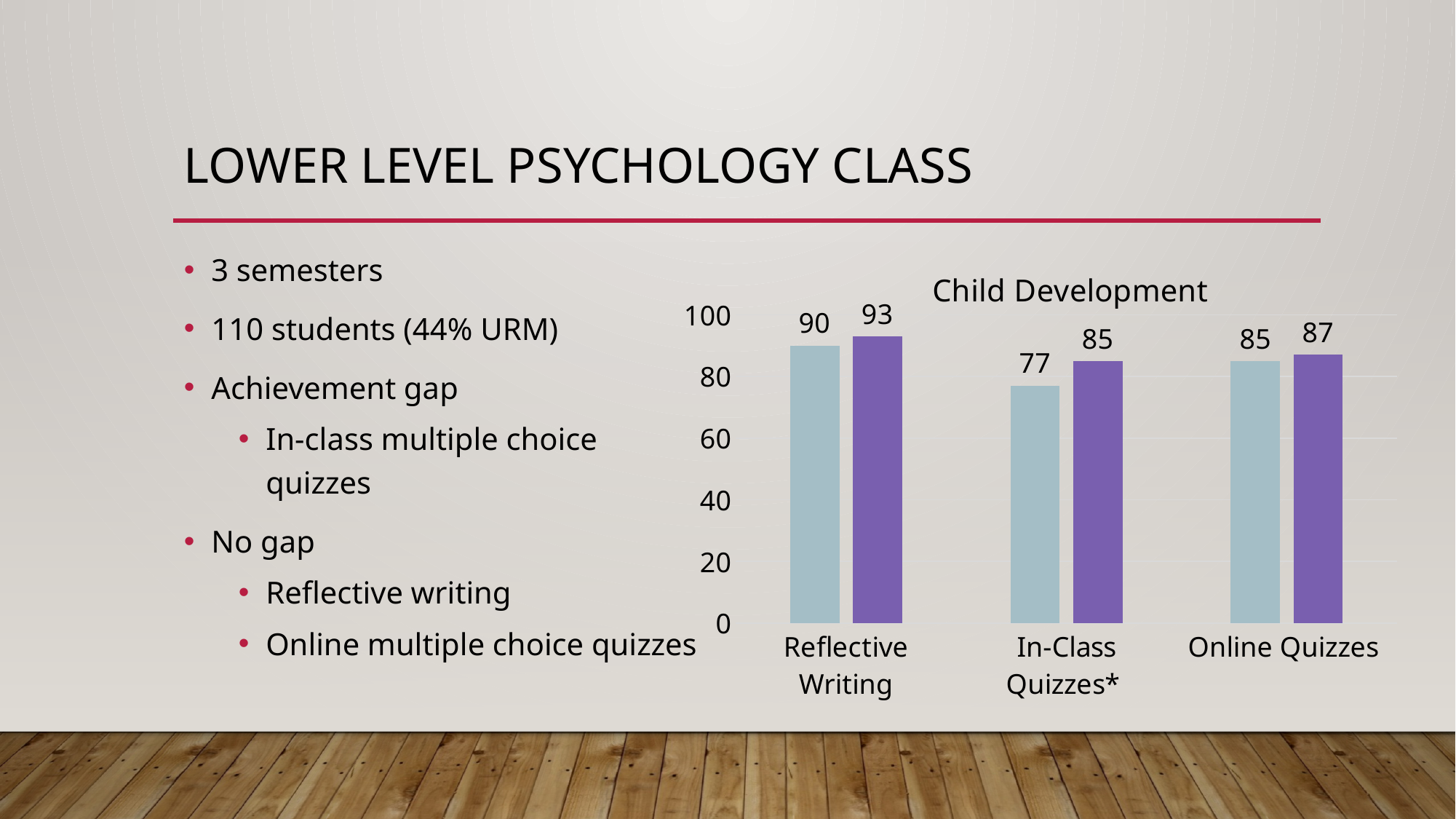
What is the value of the purple bar for Online Quizzes? 87 What is the value of the purple bar for In-Class Quizzes*? 85 Is the value of the light blue bar for In-Class Quizzes* greater or less than 80? less What is the difference between the purple bar and the light blue bar for Reflective Writing? 3 Which category has the highest purple bar? Reflective Writing What type of chart is shown on the slide? bar chart What is the value of the light blue bar for Reflective Writing? 90 What is the difference between the purple bar and the light blue bar for In-Class Quizzes*? 8 Which category has the lowest light blue bar? In-Class Quizzes* How many categories are shown on the x axis of the chart? 3 What is the title of the chart? Child Development Which is larger: the light blue bar for Online Quizzes or the light blue bar for In-Class Quizzes*? Online Quizzes